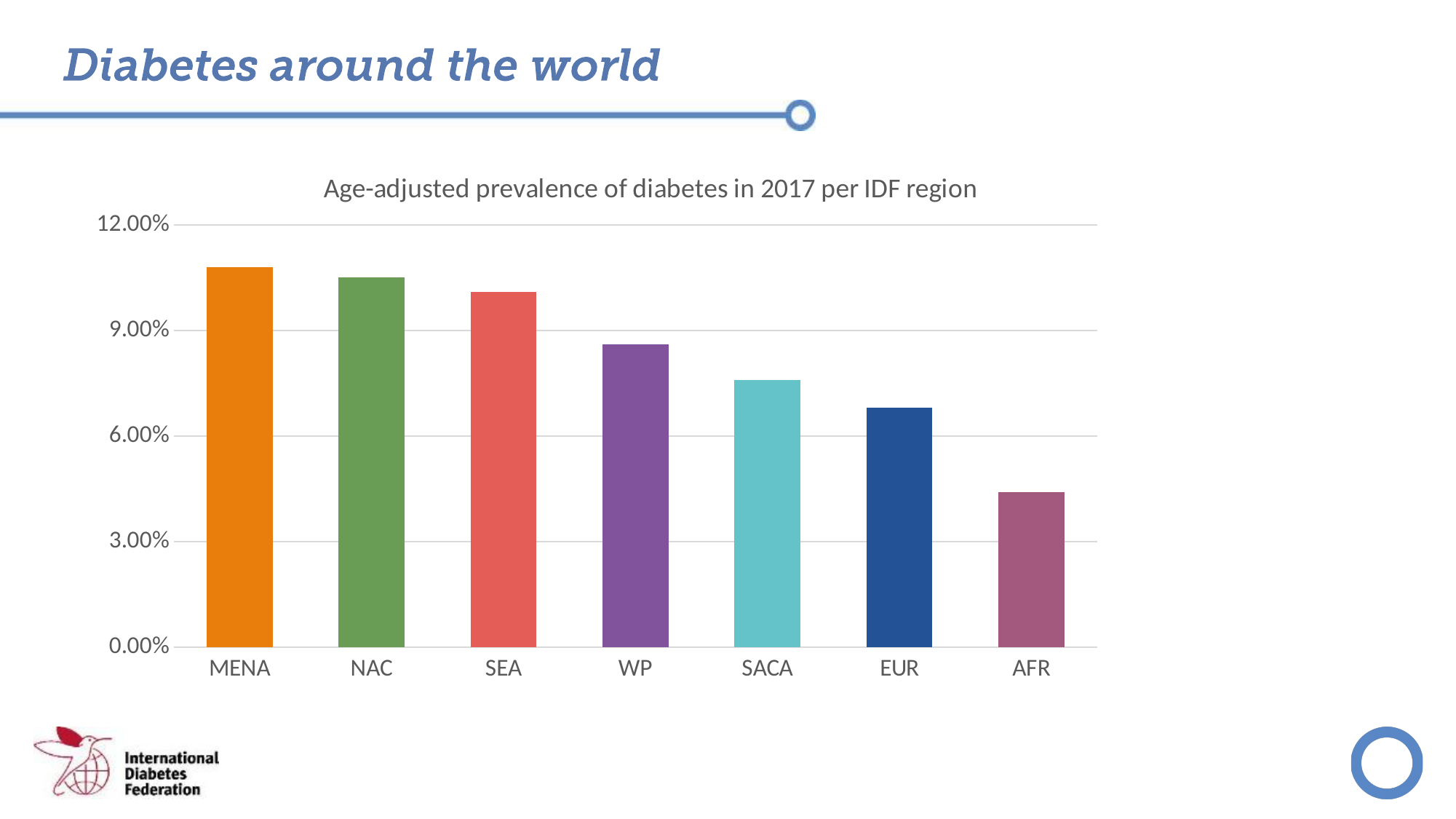
What is the title of the chart? Age-adjusted prevalence of diabetes in 2017 per IDF region Which region has the highest age-adjusted prevalence of diabetes in the chart? MENA What kind of chart is shown on the slide? bar chart Which region has the lowest age-adjusted prevalence of diabetes in the chart? AFR Is the value for SACA greater or less than 9.00%? less Which region has a higher value, EUR or SEA? SEA Is the value for EUR greater or less than 6.00%? greater Do the values rise or fall from left to right along the x axis? fall Is the value for AFR greater or less than 6.00%? less Which region has a higher value, WP or SACA? WP How many IDF regions are shown on the x axis of the chart? 7